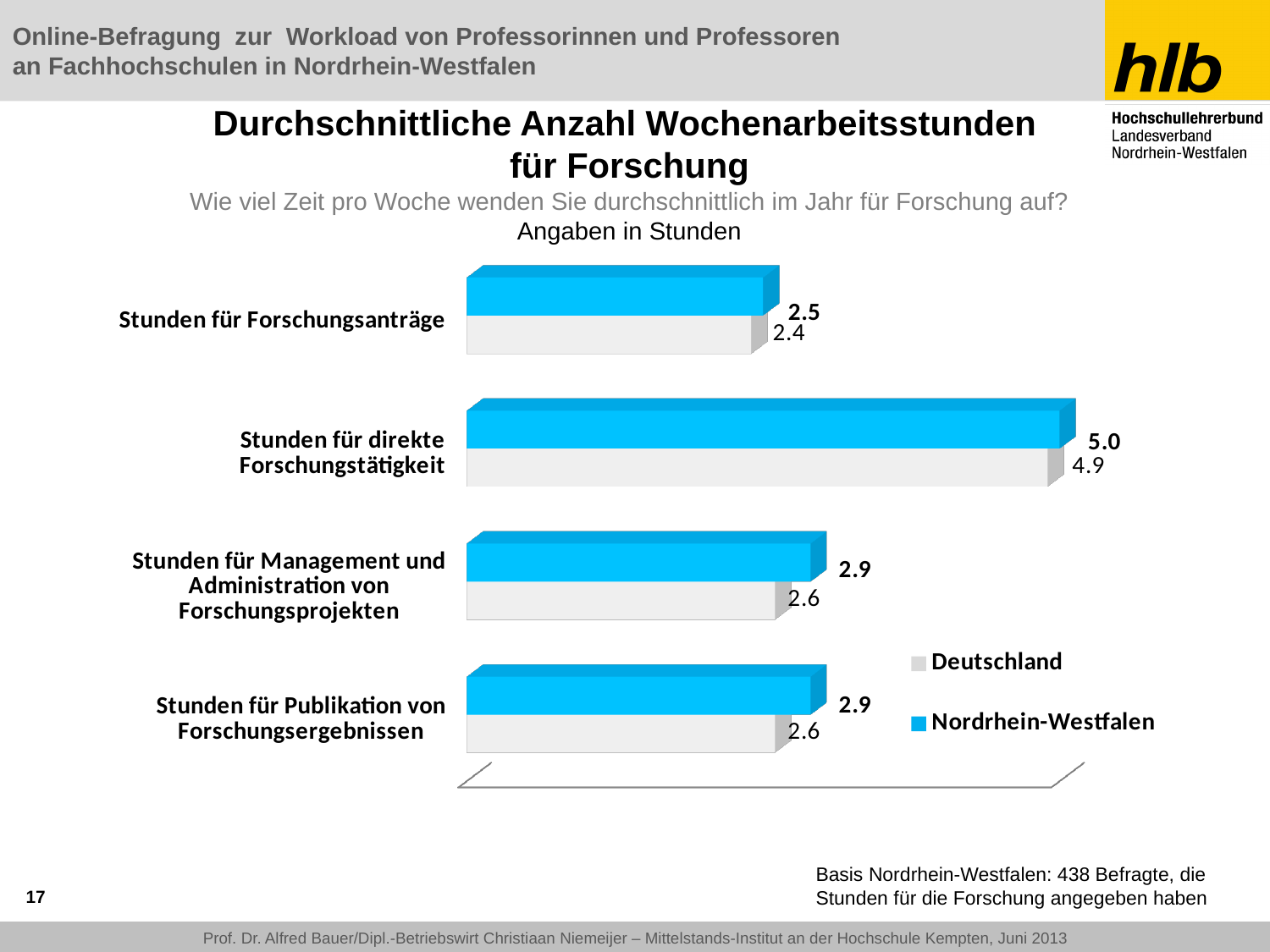
Which category has the highest value for Nordrhein-Westfalen? Stunden für direkte Forschungstätigkeit How many categories are shown in the chart? 4 What is the value for Deutschland for 'Stunden für Publikation von Forschungsergebnissen'? 2.6 Which category has the lowest value for Deutschland? Stunden für Forschungsanträge What is the value for Nordrhein-Westfalen for 'Stunden für Management und Administration von Forschungsprojekten'? 2.9 Which is larger for 'Stunden für Forschungsanträge': the Nordrhein-Westfalen value or the Deutschland value? Nordrhein-Westfalen What is the value for Deutschland for 'Stunden für Forschungsanträge'? 2.4 What is the value for Nordrhein-Westfalen for 'Stunden für direkte Forschungstätigkeit'? 5.0 What kind of chart is shown on the slide? Bar chart What is the difference between the Nordrhein-Westfalen and Deutschland values for 'Stunden für direkte Forschungstätigkeit'? 0.1 What is the difference between the Nordrhein-Westfalen and Deutschland values for 'Stunden für Management und Administration von Forschungsprojekten'? 0.3 How many series does the legend list? 2